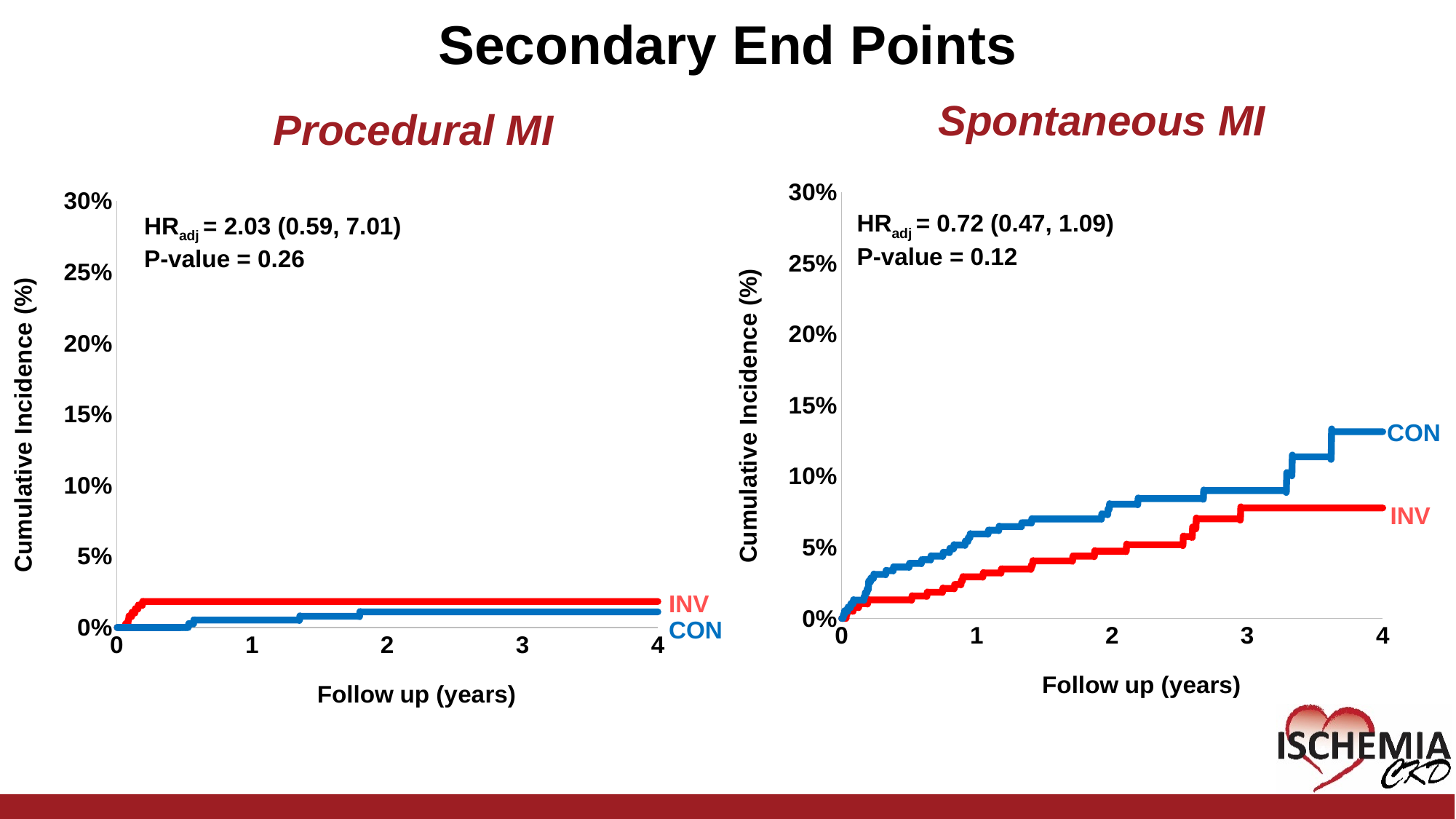
In the Procedural MI chart, which series has the higher cumulative incidence at 4 years, INV or CON? INV In the Spontaneous MI chart, is the cumulative incidence for INV at 4 years greater or less than 10%? less In the Procedural MI chart, what kind of chart is shown? line chart In the Spontaneous MI chart, how many series are plotted? 2 In the Spontaneous MI chart, which series has the higher cumulative incidence at 4 years, CON or INV? CON In the Spontaneous MI chart, does the cumulative incidence for CON rise or fall over the follow-up period? rise In the Procedural MI chart, is the cumulative incidence for INV at 4 years greater or less than 5%? less In the Spontaneous MI chart, is the cumulative incidence for CON at 4 years greater or less than 10%? greater In the Spontaneous MI chart, what P-value is shown? 0.12 In the Procedural MI chart, what is the adjusted hazard ratio shown? 2.03 (0.59, 7.01)